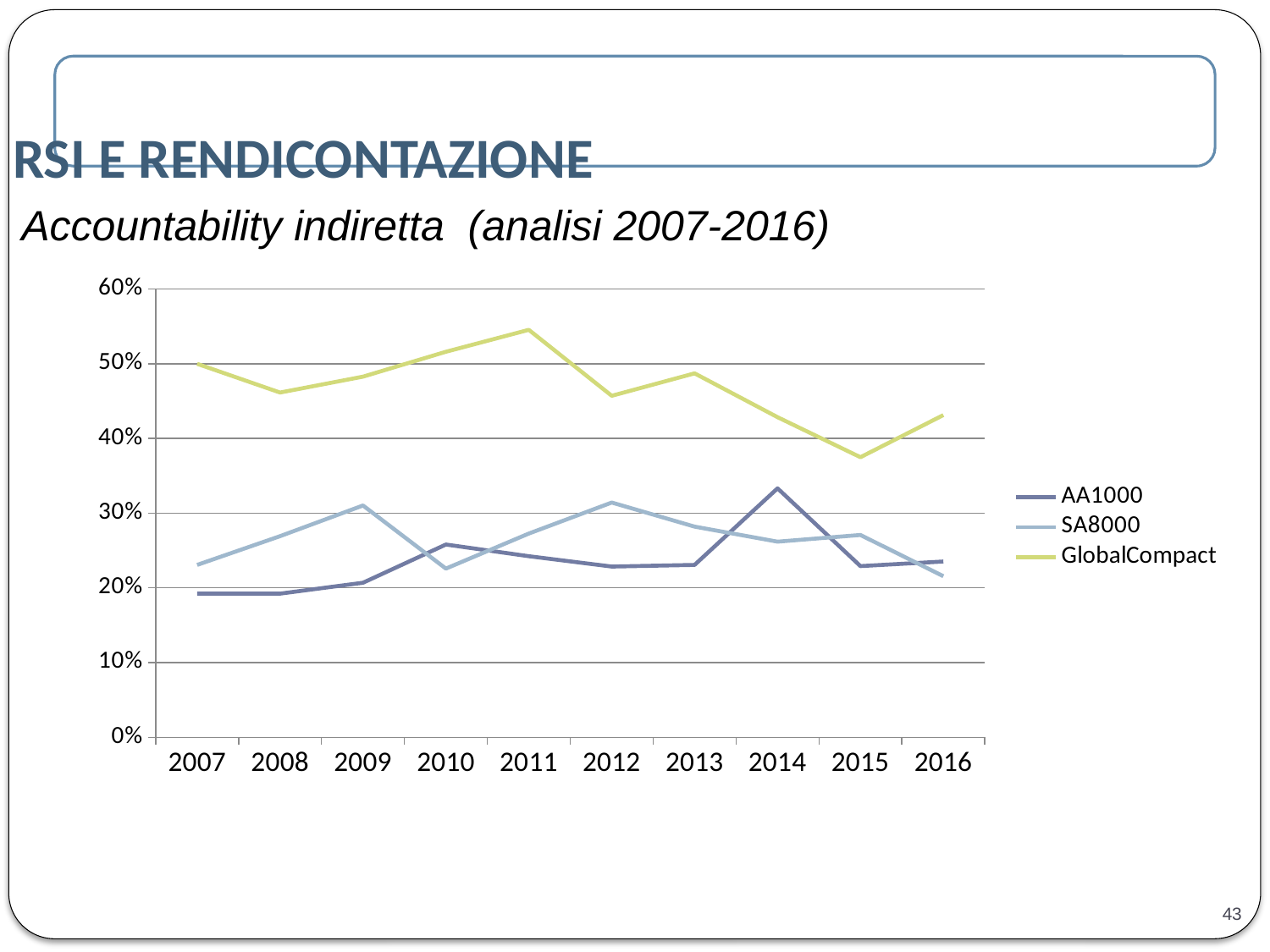
Does the GlobalCompact series rise or fall from 2011 to 2015? fall In 2014, which series has the larger value, AA1000 or SA8000? AA1000 In which year does the AA1000 series reach its highest value? 2014 In 2009, which series has the larger value, SA8000 or AA1000? SA8000 Is the value for AA1000 in 2007 greater or less than 20%? less How many years are plotted along the x axis? 10 In which year does the GlobalCompact series reach its lowest value? 2015 Is the value for GlobalCompact in 2011 greater or less than 50%? greater In which year does the GlobalCompact series reach its highest value? 2011 Is the value for GlobalCompact in 2015 greater or less than 40%? less How many series does the legend list? 3 What kind of chart is shown on the slide? line chart